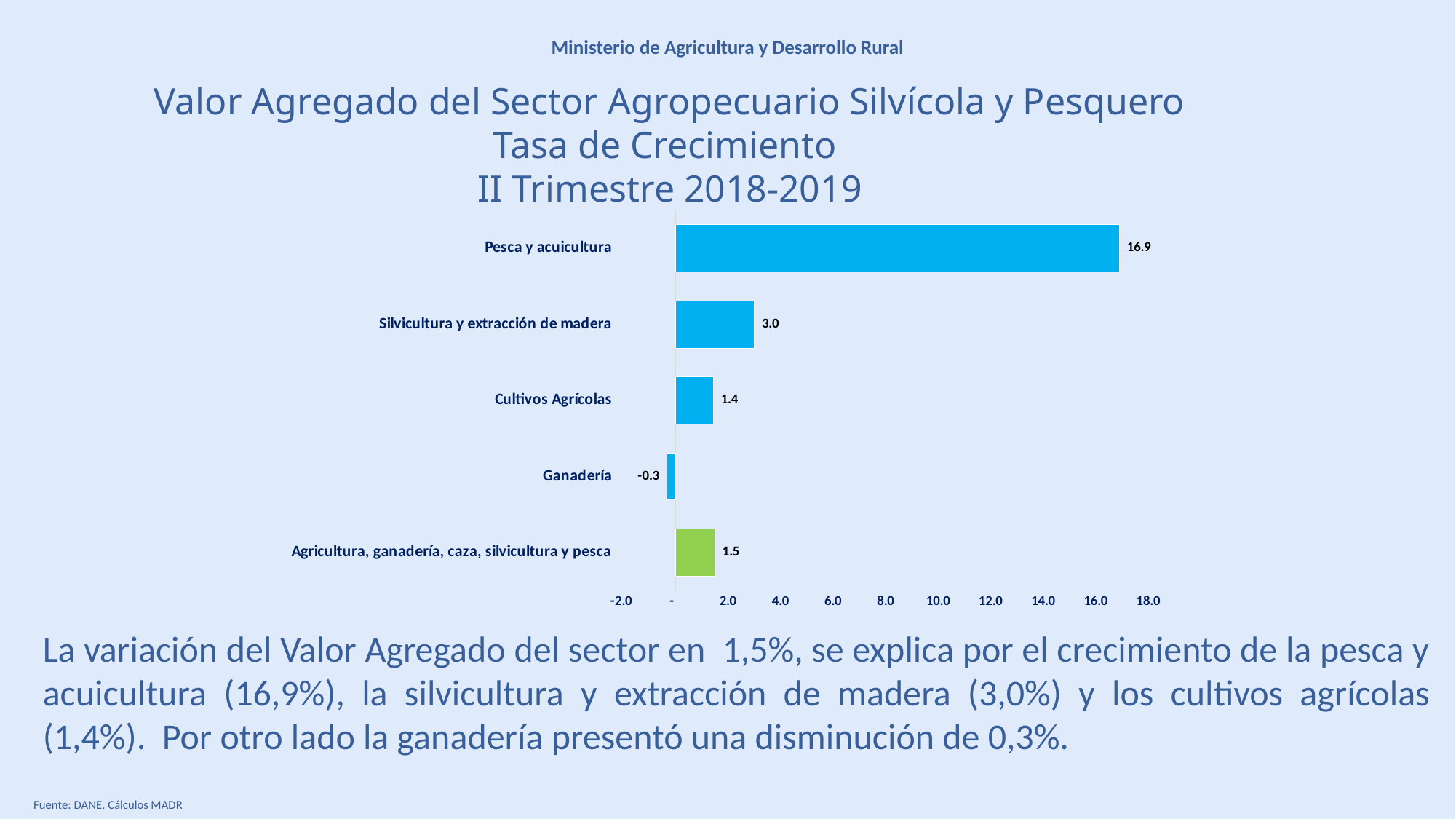
What kind of chart is shown on the slide? Bar chart What is the value for Ganadería? -0.3 Is the value for Pesca y acuicultura greater or less than 16.0? greater What is the value for Pesca y acuicultura? 16.9 Which category has the lowest value? Ganadería What is the value for Silvicultura y extracción de madera? 3.0 Which category has the highest value? Pesca y acuicultura Which category's bar is shown in green rather than blue? Agricultura, ganadería, caza, silvicultura y pesca How many categories are shown in the chart? 5 What is the difference between the values for Pesca y acuicultura and Silvicultura y extracción de madera? 13.9 Which is larger, the value for Cultivos Agrícolas or the value for Silvicultura y extracción de madera? Silvicultura y extracción de madera What is the value for Agricultura, ganadería, caza, silvicultura y pesca? 1.5